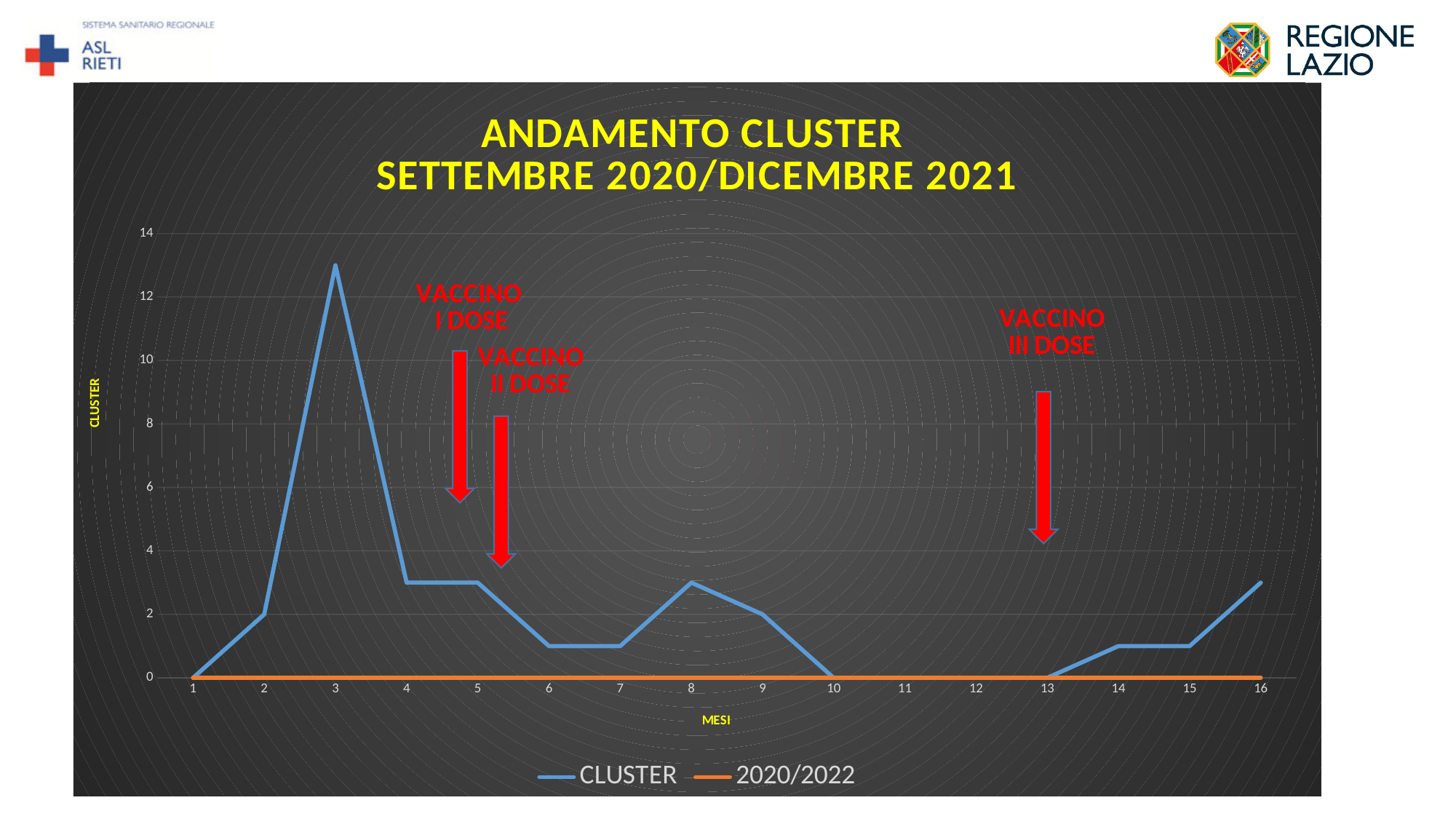
How many months are plotted along the x axis? 16 What is the label of the x axis? MESI What is the CLUSTER value at month 10? 0 What is the CLUSTER value at month 2? 2 Is the CLUSTER value at month 3 greater or less than 12? greater At which month does the CLUSTER series reach its highest value? 3 Does the CLUSTER series rise or fall between month 13 and month 16? rise How many series does the legend list? 2 What kind of chart is shown on the slide? line chart Is the CLUSTER value at month 8 greater or less than 4? less Which is larger for the CLUSTER series, the value at month 3 or the value at month 8? month 3 What is the title of the chart? ANDAMENTO CLUSTER SETTEMBRE 2020/DICEMBRE 2021